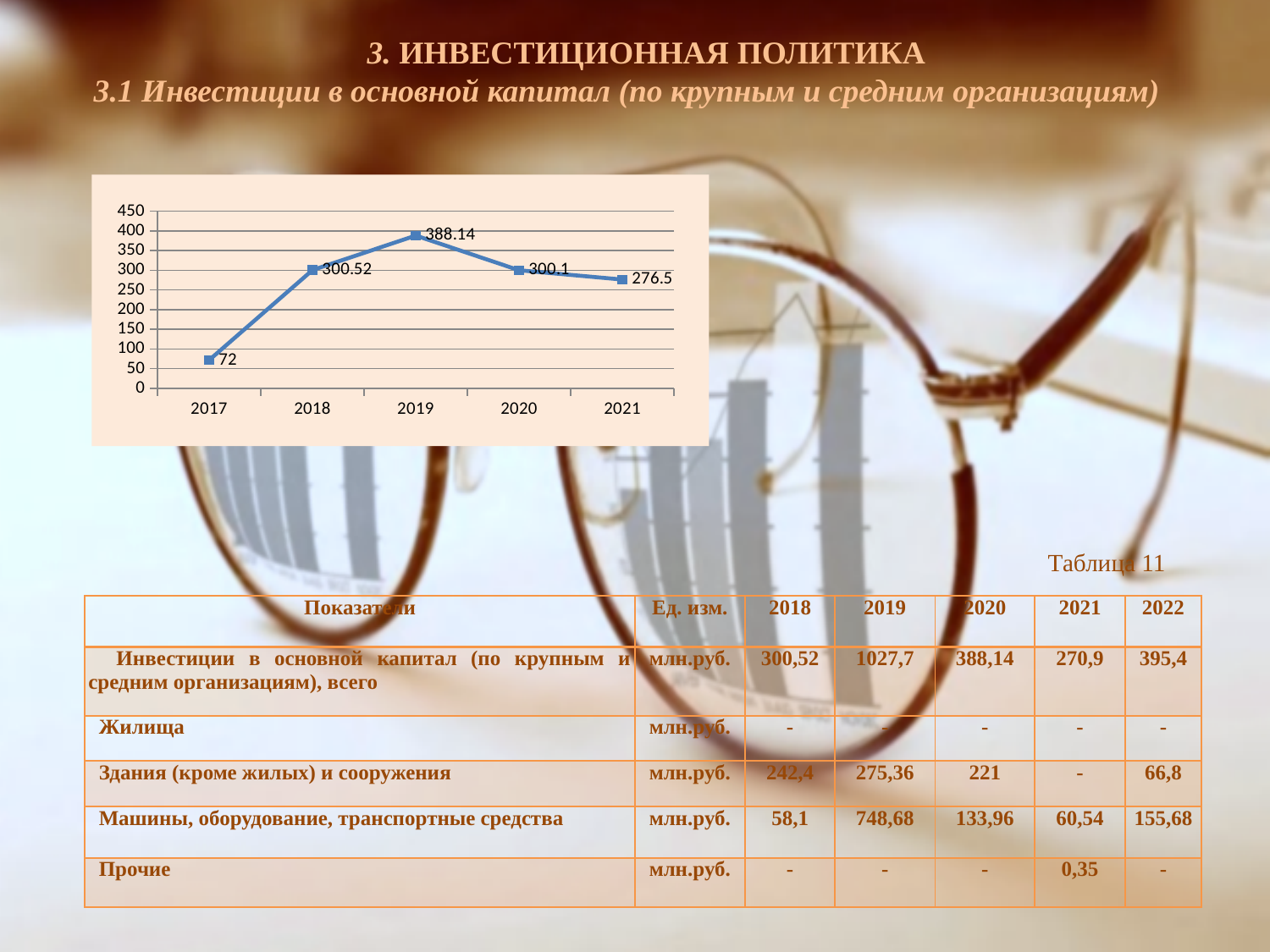
What is the value plotted for 2021 on the line chart? 276.5 How many years are plotted on the line chart? 5 What is the value plotted for 2020 on the line chart? 300.1 On the line chart, how much higher is the 2019 value than the 2018 value? 87.62 Which year has the highest value on the line chart? 2019 Which year has the lowest value on the line chart? 2017 Is the value for 2021 on the line chart greater or less than 300? less What is the value plotted for 2017 on the line chart? 72 What kind of chart is shown on the slide? line chart On the line chart, which year has the larger value, 2020 or 2021? 2020 On the line chart, how much higher is the 2018 value than the 2017 value? 228.52 What is the value plotted for 2019 on the line chart? 388.14